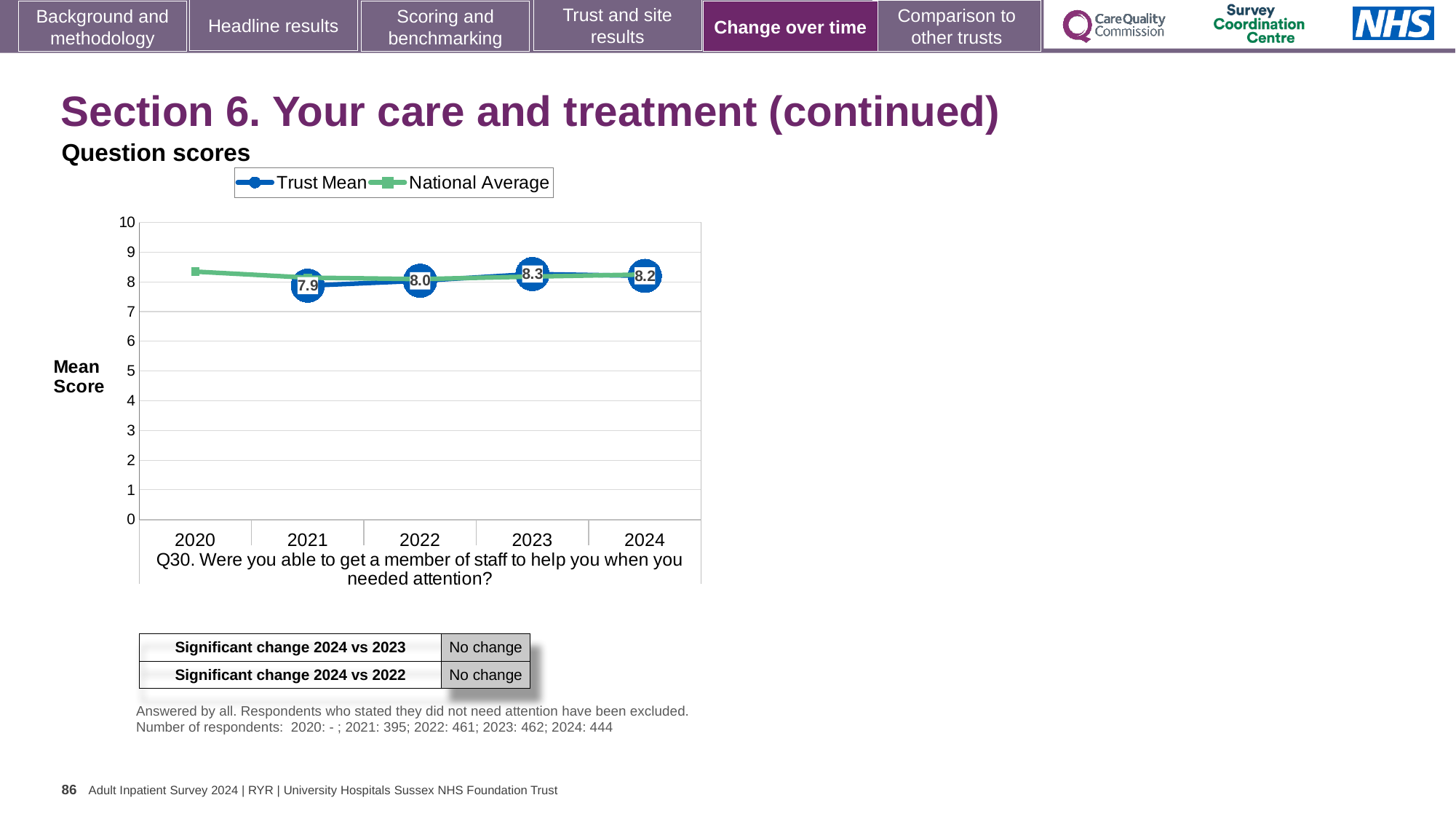
What is the Trust Mean score for 2021? 7.9 How many series does the legend list? 2 How many years are shown on the x axis? 5 What is the Trust Mean score for 2024? 8.2 What is the Trust Mean score for 2023? 8.3 What kind of chart is shown? Line chart Is the National Average value for 2020 greater or less than 8? greater Does the Trust Mean score rise or fall from 2021 to 2023? Rise In which year is the Trust Mean score lowest? 2021 What is the difference between the Trust Mean score in 2023 and in 2021? 0.4 Which is larger, the Trust Mean score for 2024 or for 2022? 2024 In which year is the Trust Mean score highest? 2023